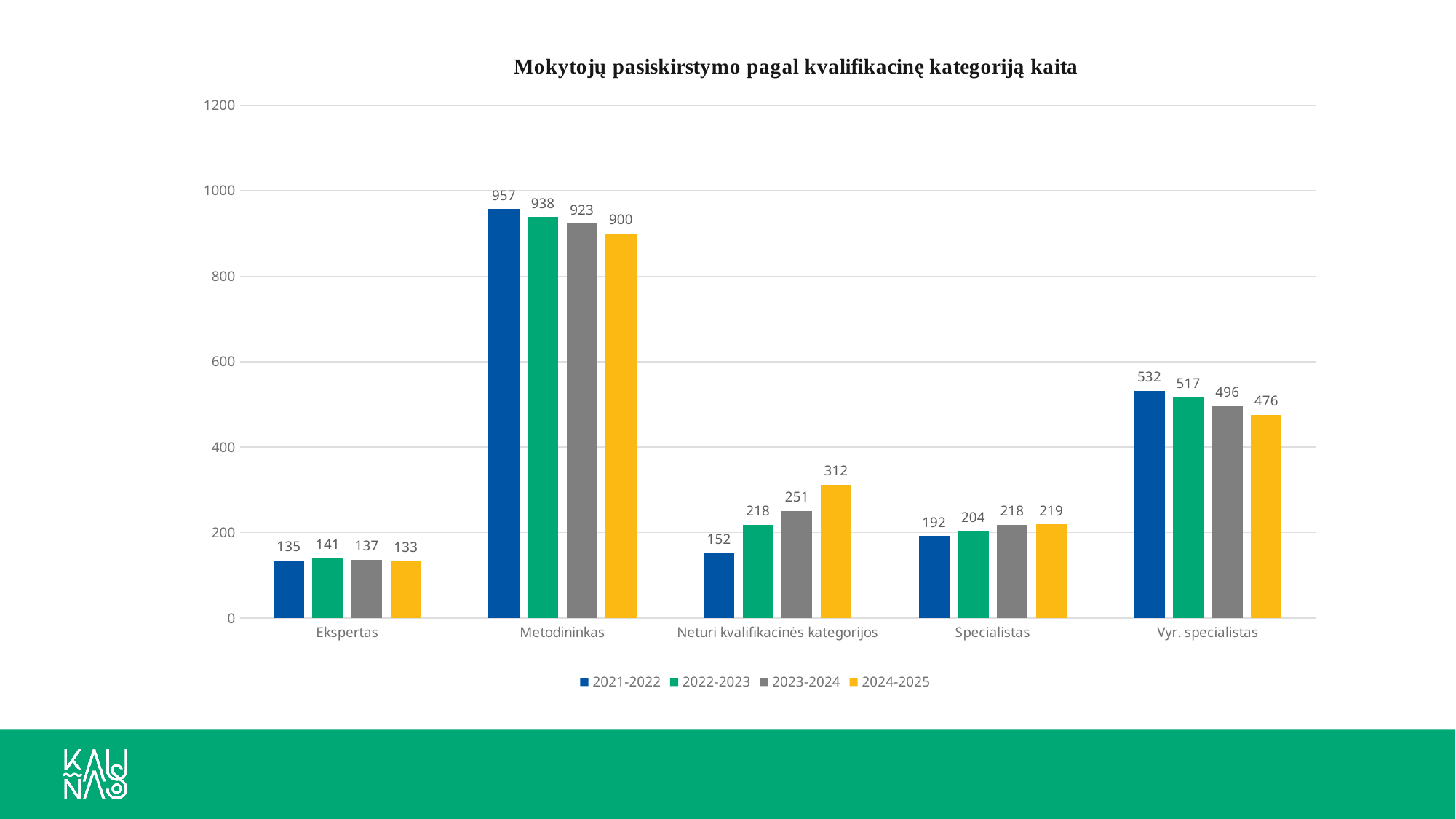
Do the values for Metodininkas rise or fall from 2021-2022 to 2024-2025? fall How many series does the legend list? 4 What is the value for Metodininkas in the 2021-2022 series? 957 Is the 2022-2023 value for Metodininkas greater or less than 800? greater What is the value for Vyr. specialistas in the 2023-2024 series? 496 Which category has the lowest value in the 2021-2022 series? Ekspertas Which is larger for Specialistas: the 2021-2022 value or the 2024-2025 value? 2024-2025 How many categories are shown on the x axis? 5 What kind of chart is shown on the slide? bar chart What is the value for Neturi kvalifikacinės kategorijos in the 2024-2025 series? 312 Which category has the highest value in the 2024-2025 series? Metodininkas What is the difference between the 2021-2022 and 2024-2025 values for Vyr. specialistas? 56